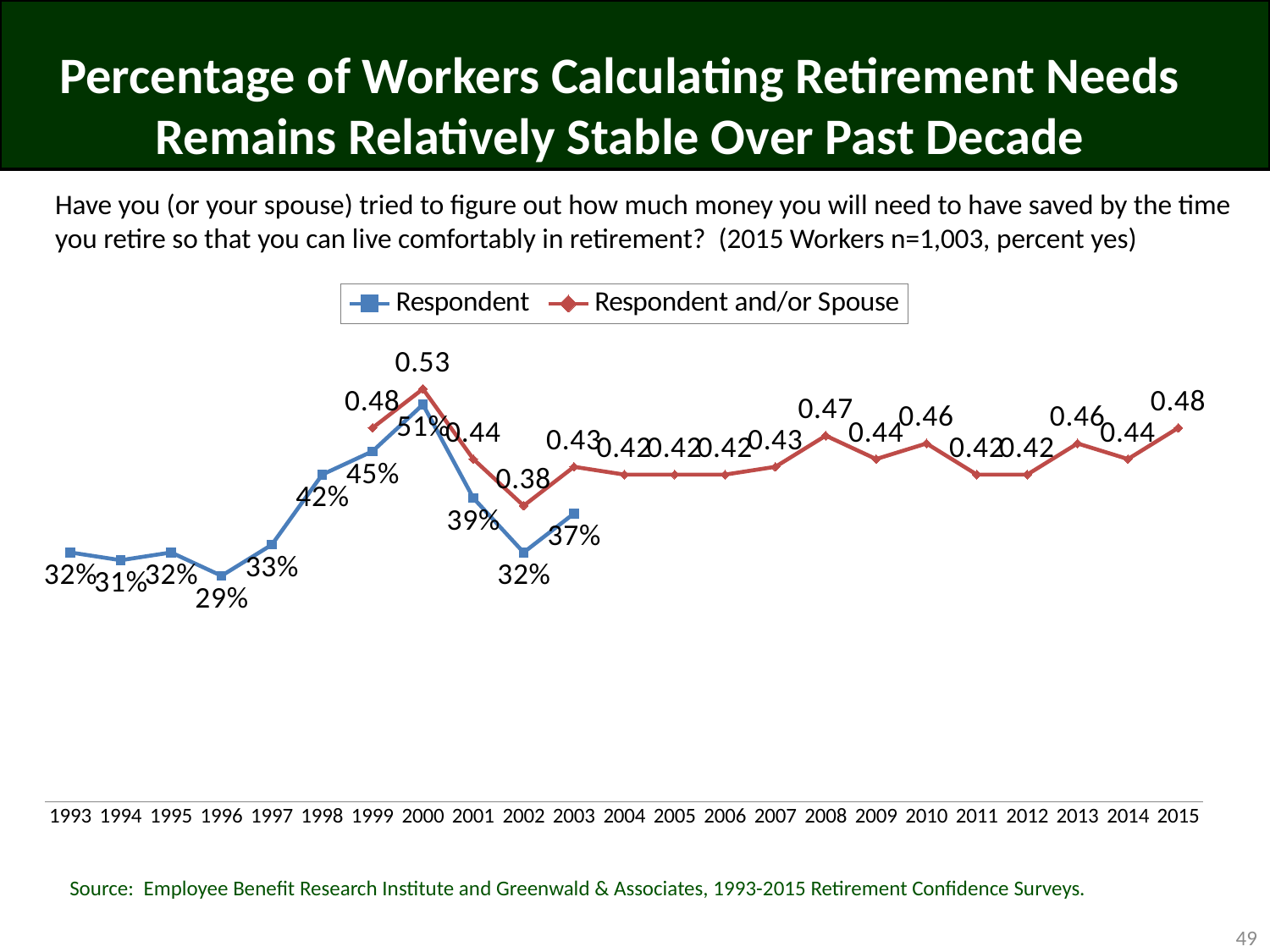
What is the value for Respondent and/or Spouse in 2002? 0.38 In which year is the Respondent series at its lowest value? 1996 What kind of chart is shown on the slide? Line chart What is the first year shown on the x axis? 1993 What is the difference between the Respondent values in 2000 and 2001? 12% What is the value for Respondent and/or Spouse in 2015? 0.48 What is the value for Respondent in 1996? 29% Which is larger: the Respondent and/or Spouse value in 2008 or in 2011? 2008 Does the Respondent series rise or fall from 1997 to 2000? Rise In which year does the Respondent and/or Spouse series reach its highest value? 2000 How many series does the legend list? 2 What is the value for Respondent in 2000? 51%